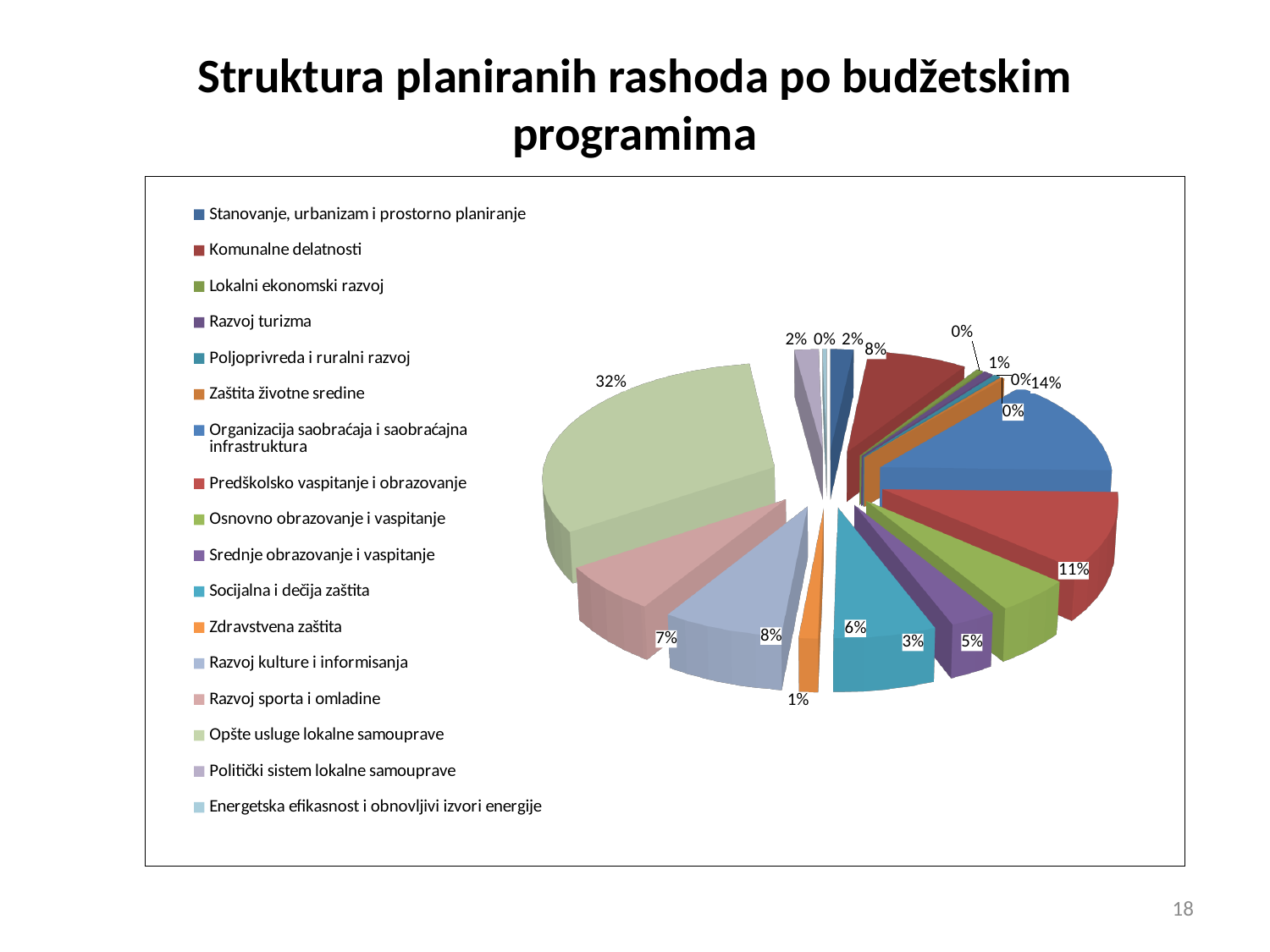
Which has a larger share: Opšte usluge lokalne samouprave or Organizacija saobraćaja i saobraćajna infrastruktura? Opšte usluge lokalne samouprave What share of the pie does Socijalna i dečija zaštita have? 6% What share of the pie does Razvoj kulture i informisanja have? 8% What share of the pie does Predškolsko vaspitanje i obrazovanje have? 11% What is the title of the chart on the slide? Struktura planiranih rashoda po budžetskim programima How many categories does the legend of the pie chart list? 17 Which category has the largest share of the pie? Opšte usluge lokalne samouprave By how many percentage points does the share of Opšte usluge lokalne samouprave exceed that of Organizacija saobraćaja i saobraćajna infrastruktura? 18 percentage points What kind of chart is shown on the slide? pie chart